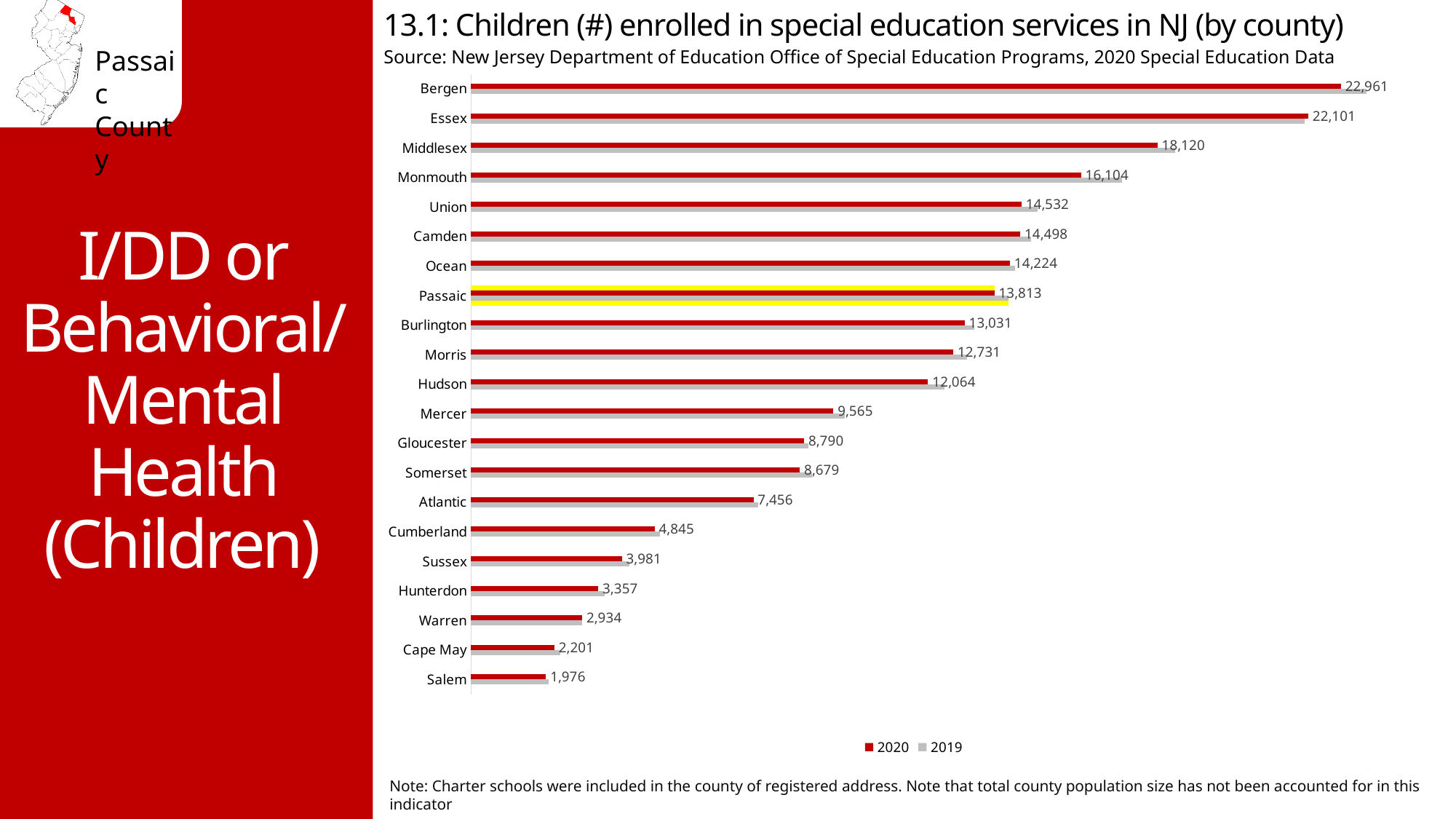
What is the 2020 value for Passaic? 13,813 What is the 2020 value for Bergen? 22,961 Which county has the lowest 2020 value? Salem How many counties are shown in the chart? 21 Which county has the highest 2020 value? Bergen Which has a larger 2020 value, Ocean or Passaic? Ocean Which series is shown in red in the legend? 2020 What is the difference between the 2020 values for Passaic and Burlington? 782 What kind of chart is shown on the slide? bar chart What is the difference between the 2020 values for Bergen and Essex? 860 What is the 2020 value for Salem? 1,976 How many series does the legend list? 2